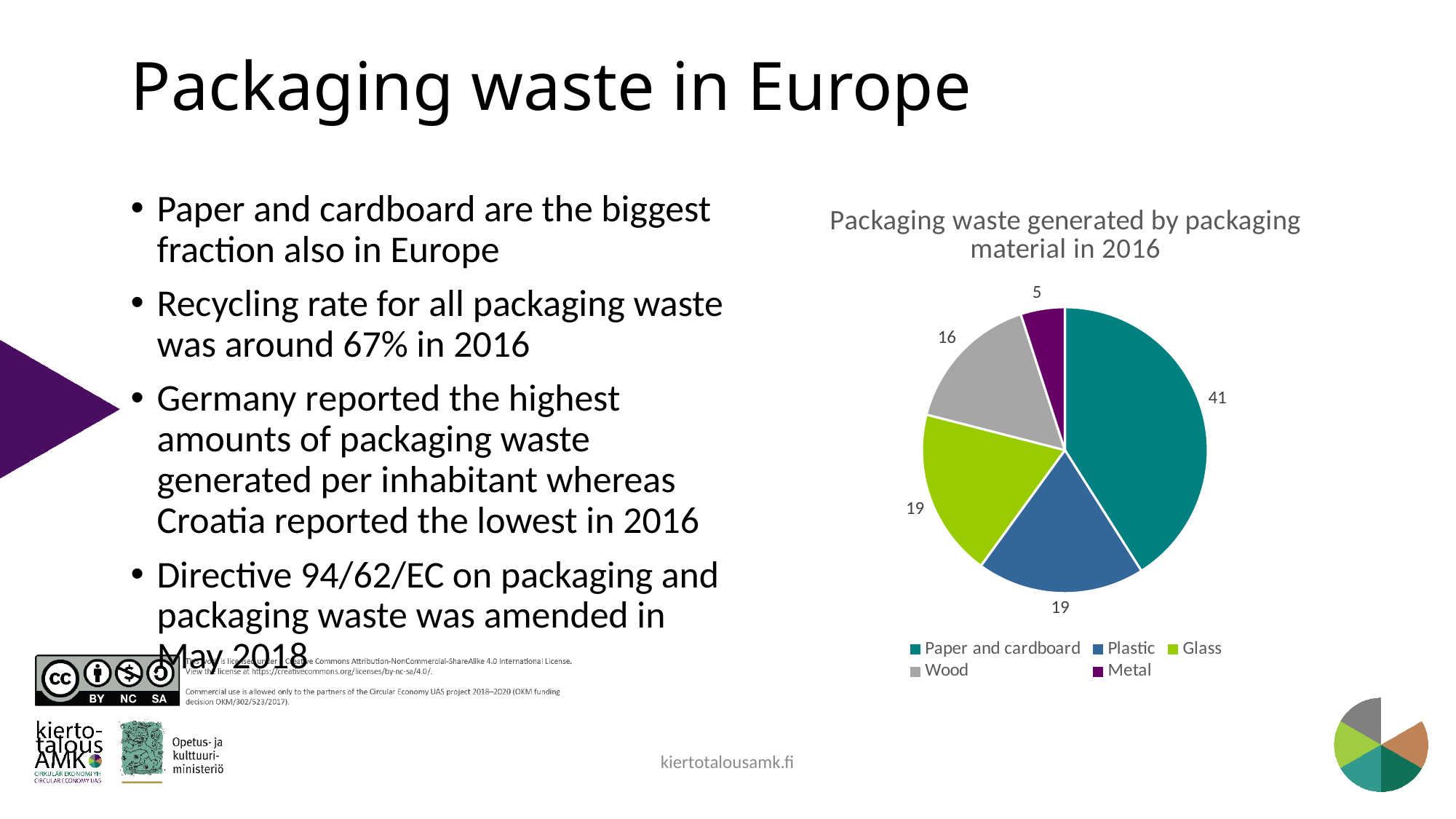
What type of chart is shown on the slide? pie chart What is the title of the chart? Packaging waste generated by packaging material in 2016 Which packaging material has the smallest slice of the pie? Metal What share of the pie does Paper and cardboard represent? 41% Which packaging material has the largest slice of the pie? Paper and cardboard What is the value for Plastic in the pie chart? 19 How many categories does the pie chart show? 5 Which is larger, the value for Glass or the value for Metal? Glass What is the value for Metal in the pie chart? 5 What is the difference between the values for Paper and cardboard and Wood? 25 What is the value for Paper and cardboard in the pie chart? 41 What is the value for Wood in the pie chart? 16